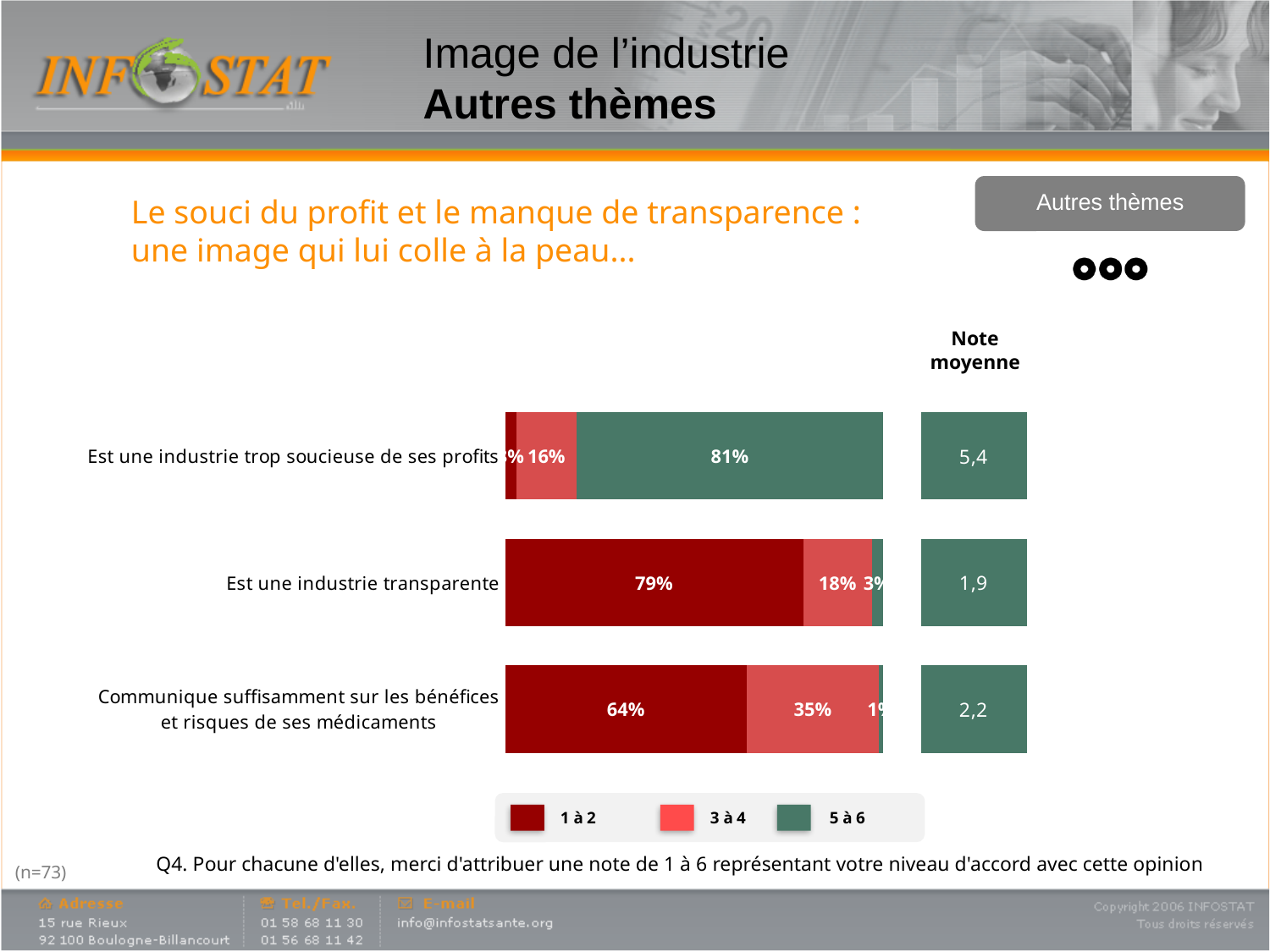
What is the "Note moyenne" for "Est une industrie trop soucieuse de ses profits"? 5,4 What kind of chart is shown on the slide? Stacked bar chart What percentage gave a score of 1 à 2 for "Est une industrie transparente"? 79% What percentage gave a score of 3 à 4 for "Est une industrie transparente"? 18% What percentage gave a score of 3 à 4 for "Communique suffisamment sur les bénéfices et risques de ses médicaments"? 35% What percentage gave a score of 5 à 6 for "Est une industrie trop soucieuse de ses profits"? 81% Which statement has the highest "Note moyenne"? Est une industrie trop soucieuse de ses profits How many series does the chart legend list? 3 What is the "Note moyenne" for "Est une industrie transparente"? 1,9 What is the difference between the 1 à 2 share for "Est une industrie transparente" and the 1 à 2 share for "Communique suffisamment sur les bénéfices et risques de ses médicaments"? 15 percentage points How many opinion statements (categories) are plotted in the chart? 3 Which statement has the larger 3 à 4 share: "Est une industrie transparente" or "Communique suffisamment sur les bénéfices et risques de ses médicaments"? Communique suffisamment sur les bénéfices et risques de ses médicaments